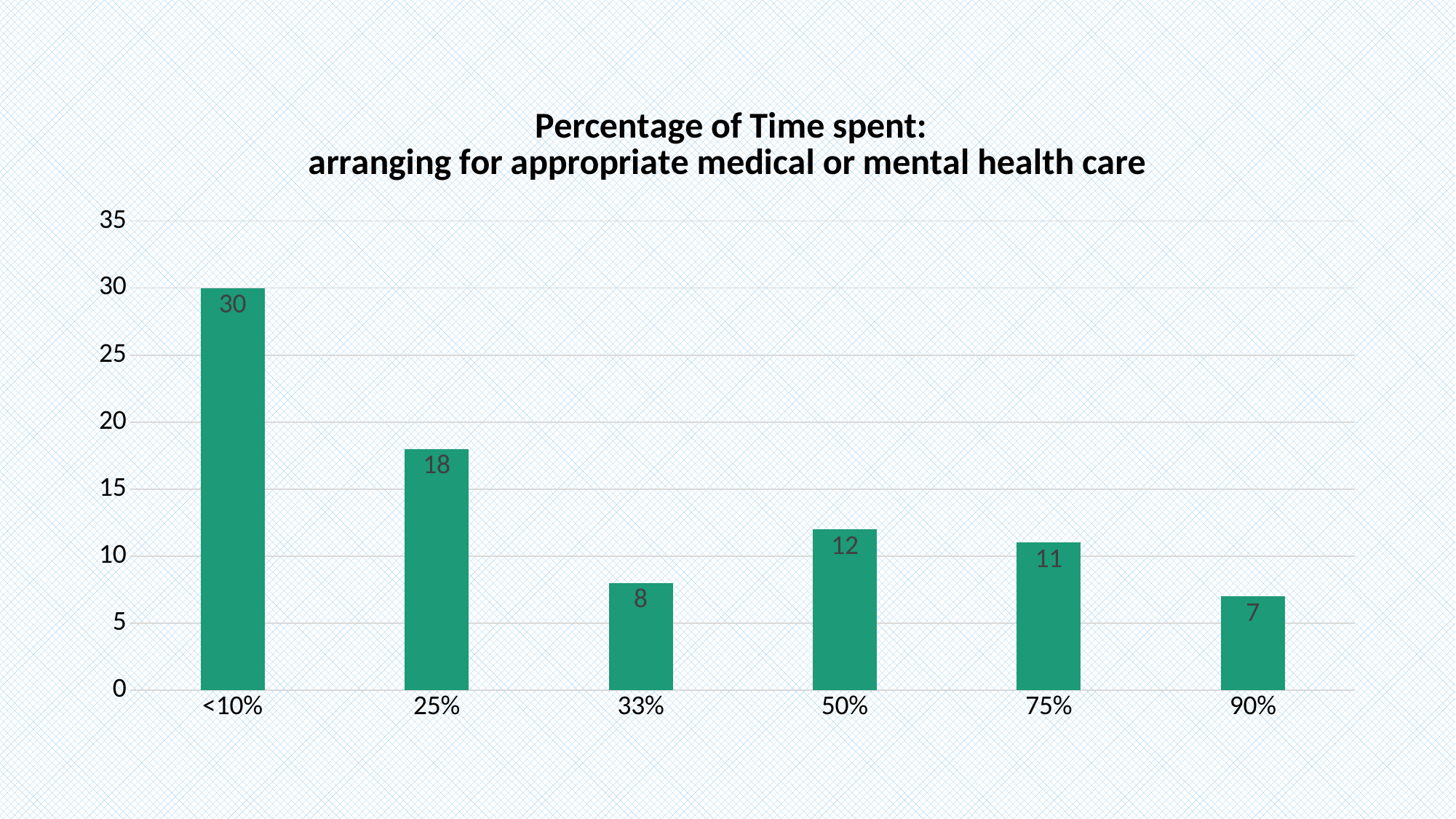
What is the value for the 50% category? 12 What is the difference between the values for <10% and 25%? 12 What is the value for the 90% category? 7 Which category has the lowest value? 90% Which category has the highest value? <10% What kind of chart is shown on the slide? bar chart What is the value for the <10% category? 30 How many categories are shown on the x axis? 6 Is the value for 25% greater or less than 20? less What is the title of the chart? Percentage of Time spent: arranging for appropriate medical or mental health care What is the value for the 25% category? 18 Which is larger, the value for 33% or the value for 75%? 75%